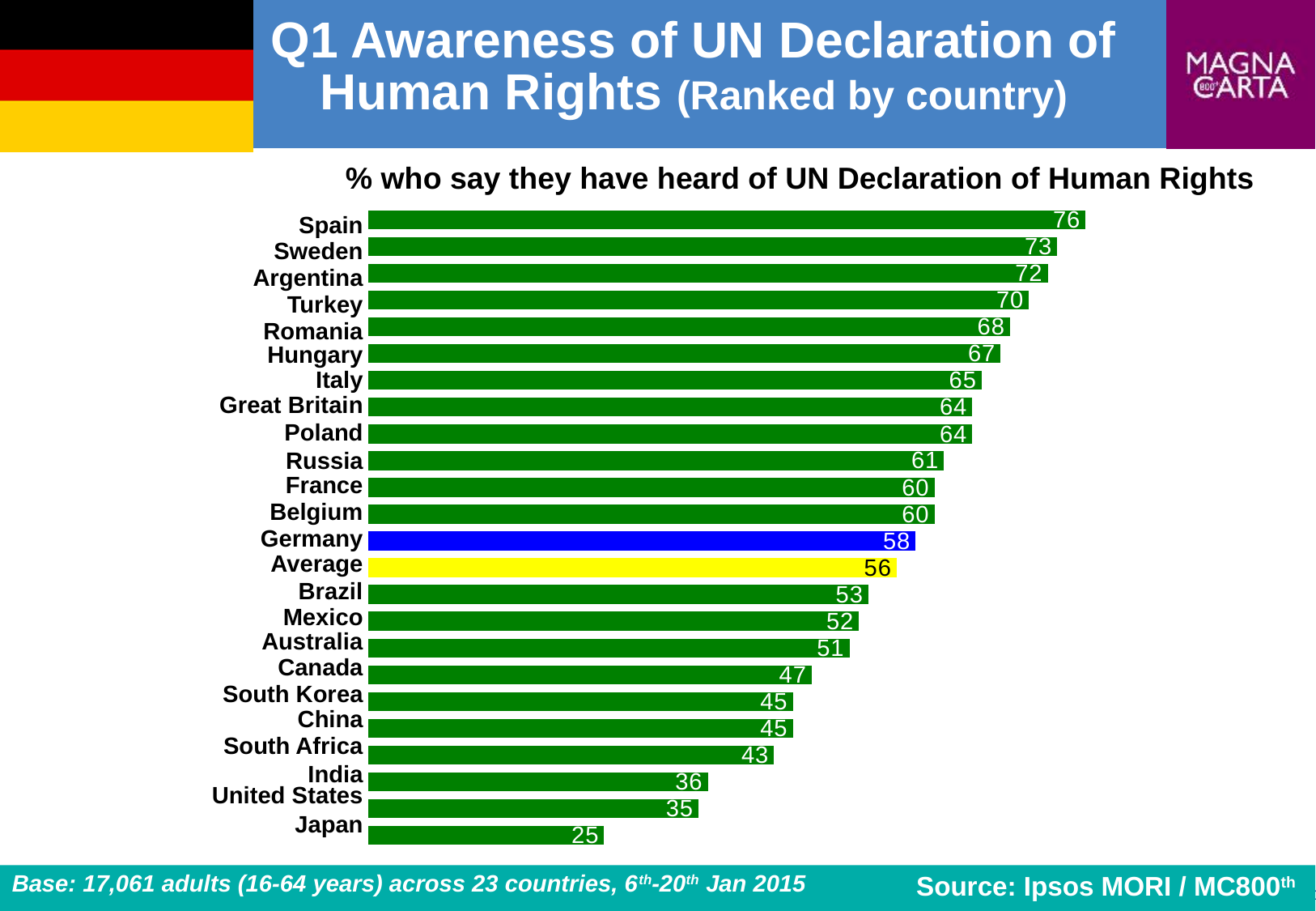
What is the value for South Africa? 43 What colour is the bar for Germany? Blue What is the value for the Average bar? 56 What is the difference between the values for Germany and the Average? 2 What kind of chart is shown on the slide? Bar chart Which country has the lowest value? Japan What is the difference between the values for Spain and Japan? 51 Which has a larger value, Canada or Brazil? Brazil Which country has the highest value? Spain What is the value for Spain? 76 What is the value for Germany? 58 How many bars are shown in the chart? 24